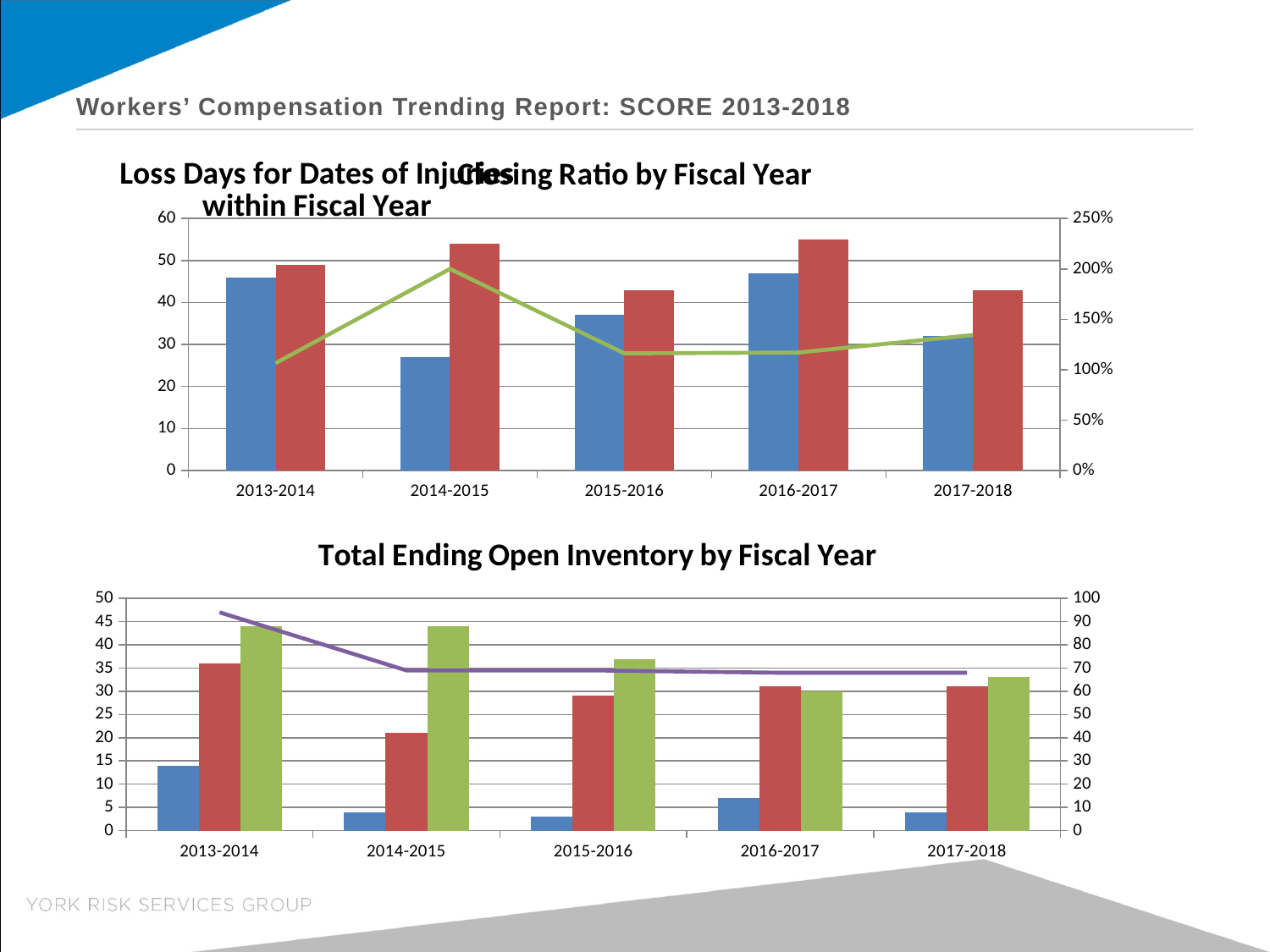
In the 'Total Ending Open Inventory by Fiscal Year' chart, does the purple line rise or fall from 2013-2014 to 2017-2018? fall How many fiscal years are shown on the x axis of the top chart? 5 In the 'Total Ending Open Inventory by Fiscal Year' chart, which fiscal year has the tallest blue bar? 2013-2014 In the top chart, is the blue bar for 2014-2015 greater or less than 30? less In the 'Total Ending Open Inventory by Fiscal Year' chart, is the red bar for 2014-2015 greater or less than 25? less What kind of chart is the 'Total Ending Open Inventory by Fiscal Year' chart? combination bar and line chart In the 'Total Ending Open Inventory by Fiscal Year' chart, is the red bar for 2013-2014 greater or less than 30? greater In the 'Total Ending Open Inventory by Fiscal Year' chart, for 2013-2014, which is taller: the red bar or the green bar? the green bar How many fiscal years are shown on the x axis of the 'Total Ending Open Inventory by Fiscal Year' chart? 5